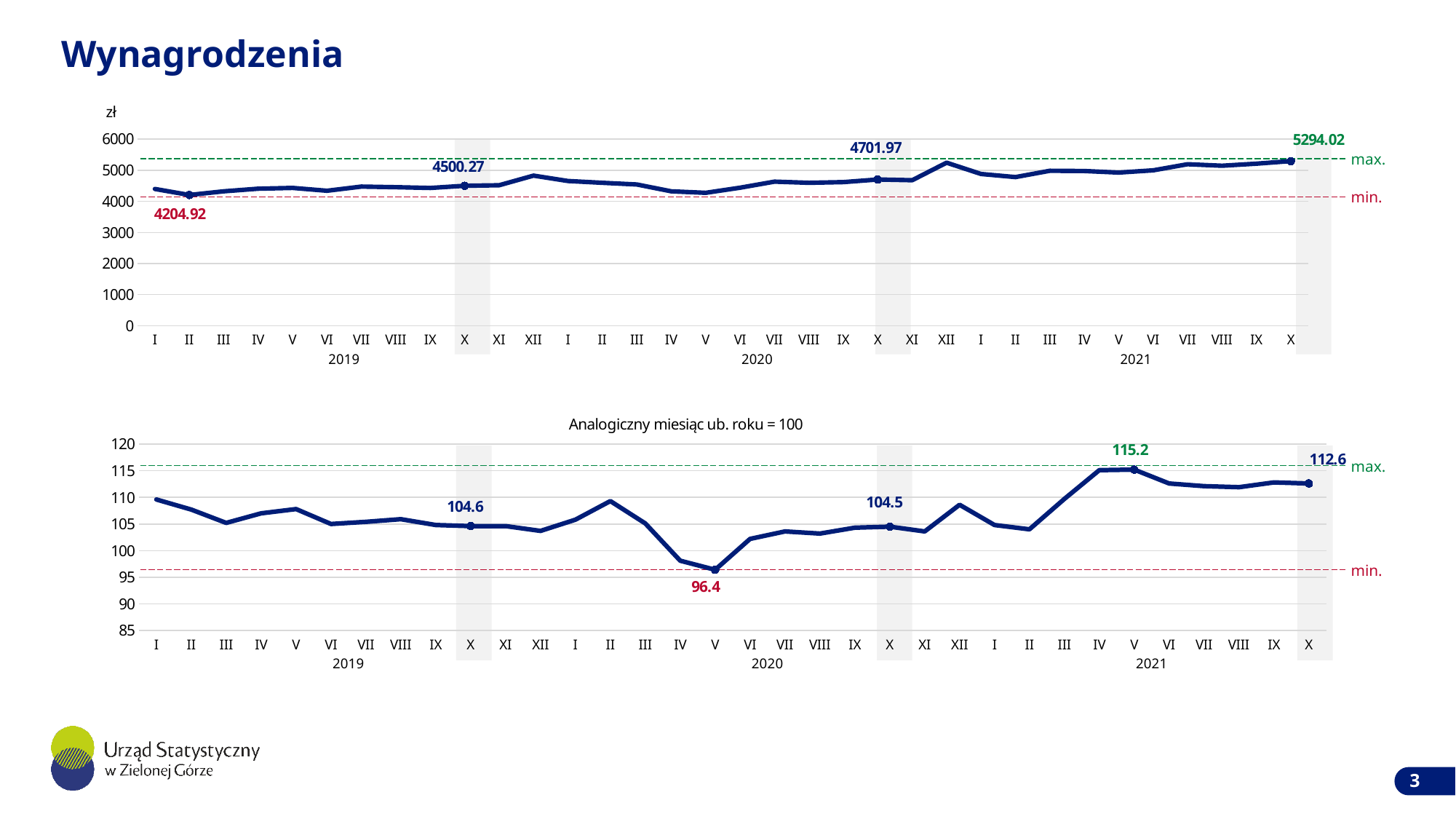
In the top chart (zł), what is the value for October 2020? 4701.97 In the top chart (zł), what is the value for October 2021? 5294.02 In the top chart (zł), is the value for December 2020 greater or less than 5000? greater What kind of chart is the top chart? line chart In the top chart (zł), which month has the lowest value? II 2019 In the bottom chart (Analogiczny miesiąc ub. roku = 100), what is the value for May 2020? 96.4 In the bottom chart (Analogiczny miesiąc ub. roku = 100), which is larger: the value for October 2019 or October 2020? October 2019 In the top chart (zł), what is the value for October 2019? 4500.27 In the top chart (zł), what is the difference between the October 2021 value and the October 2020 value? 592.05 In the bottom chart (Analogiczny miesiąc ub. roku = 100), which month has the highest value? V 2021 How many monthly data points are plotted in the top chart? 34 In the bottom chart (Analogiczny miesiąc ub. roku = 100), what is the difference between the May 2021 value and the October 2021 value? 2.6